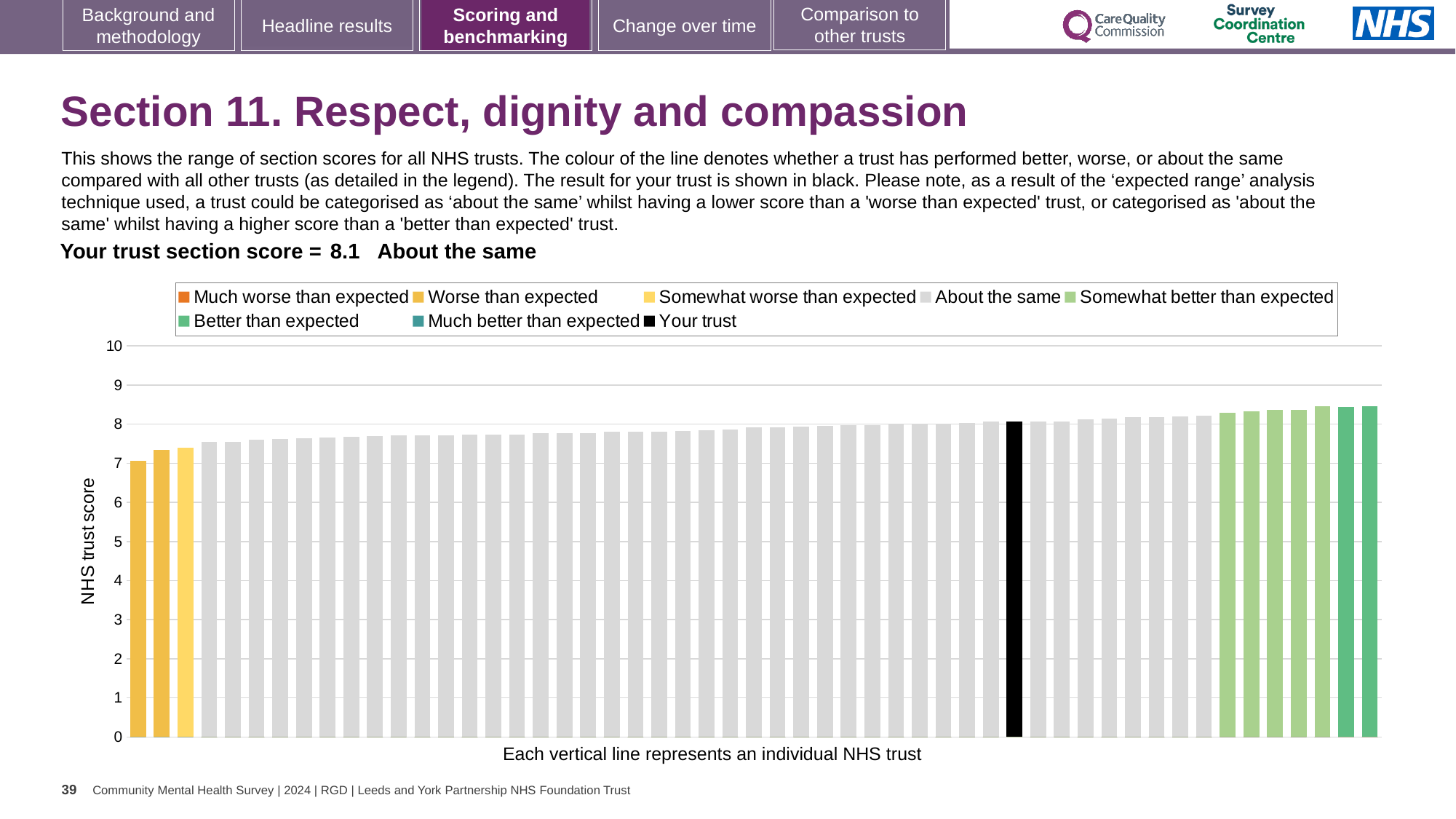
Do the bar values rise or fall moving from left to right along the x axis? rise What is the label on the vertical axis of the chart? NHS trust score Is the value for your trust (the black bar) greater or less than 9? less What colour is used for the bar representing your trust? black Is the value of the rightmost (highest) bar greater or less than 9? less Is the value for your trust (the black bar) greater or less than 7? greater What kind of chart is shown on the slide? bar chart Which performance category is your trust placed in for Section 11? About the same What is the section score for your trust shown on the slide? 8.1 How many entries does the chart legend list? 8